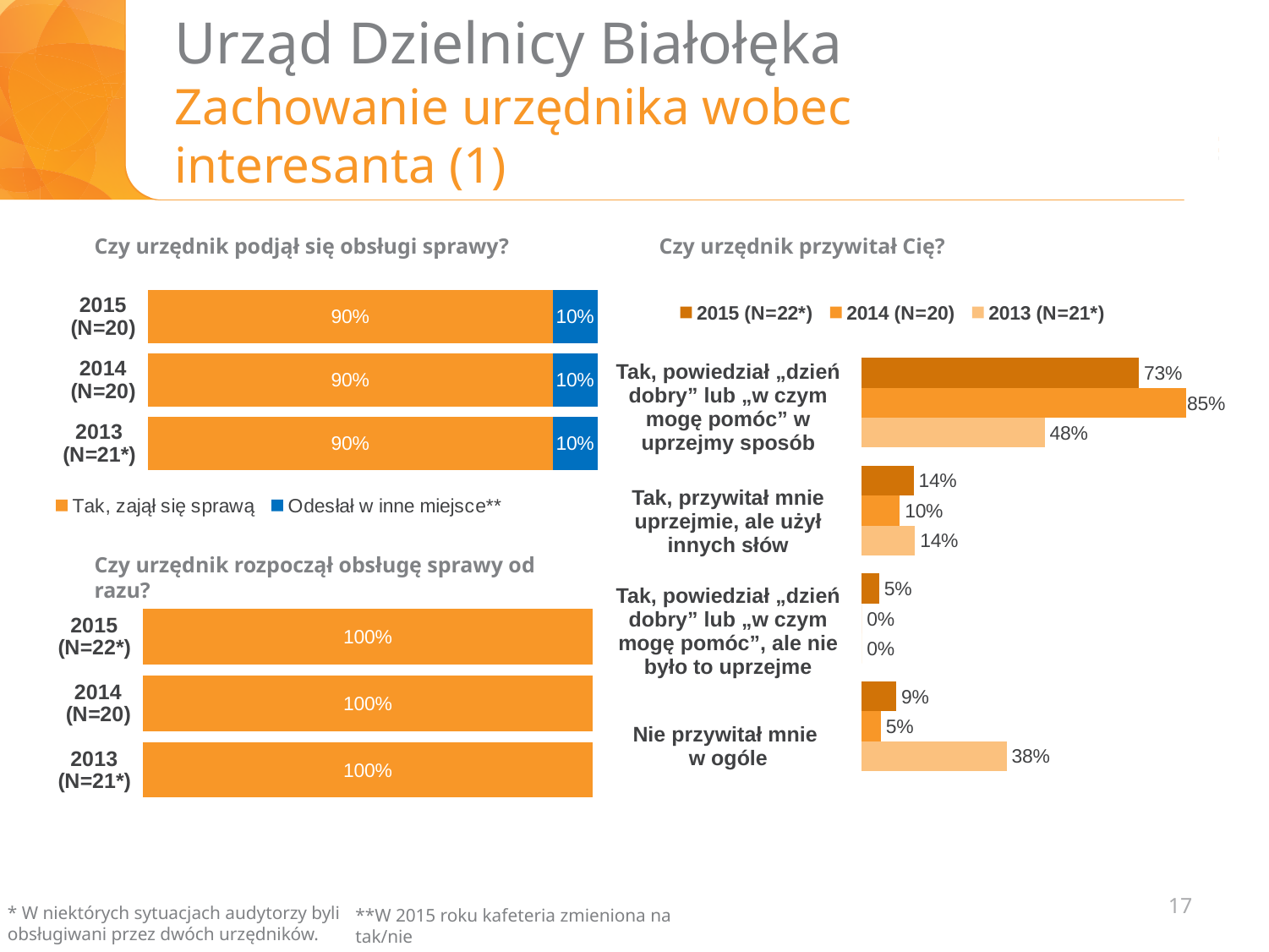
In the chart "Czy urzędnik rozpoczął obsługę sprawy od razu?", what is the value for 2014 (N=20)? 100% In the chart "Czy urzędnik przywitał Cię?", what is the value for 2013 (N=21*) in the category "Nie przywitał mnie w ogóle"? 38% What kind of chart is "Czy urzędnik rozpoczął obsługę sprawy od razu?"? Bar chart How many series does the legend of the chart "Czy urzędnik przywitał Cię?" list? 3 In the chart "Czy urzędnik przywitał Cię?", which is larger for "Nie przywitał mnie w ogóle": the 2015 (N=22*) value or the 2014 (N=20) value? 2015 (N=22*) In the chart "Czy urzędnik podjął się obsługi sprawy?", what is the total of the stacked bar for 2013 (N=21*)? 100% In the chart "Czy urzędnik przywitał Cię?", what is the value for 2014 (N=20) in the category "Tak, powiedział „dzień dobry” lub „w czym mogę pomóc” w uprzejmy sposób"? 85% In the chart "Czy urzędnik przywitał Cię?", which year has the highest value in the category "Tak, powiedział „dzień dobry” lub „w czym mogę pomóc” w uprzejmy sposób"? 2014 (N=20) What are the two legend entries of the chart "Czy urzędnik podjął się obsługi sprawy?"? Tak, zajął się sprawą; Odesłał w inne miejsce** In the chart "Czy urzędnik przywitał Cię?", what is the difference between the 2014 (N=20) and 2013 (N=21*) values in the category "Tak, powiedział „dzień dobry” lub „w czym mogę pomóc” w uprzejmy sposób"? 37 percentage points In the chart "Czy urzędnik podjął się obsługi sprawy?", what is the value of "Odesłał w inne miejsce**" for 2015 (N=20)? 10% How many categories are shown in the chart "Czy urzędnik przywitał Cię?"? 4